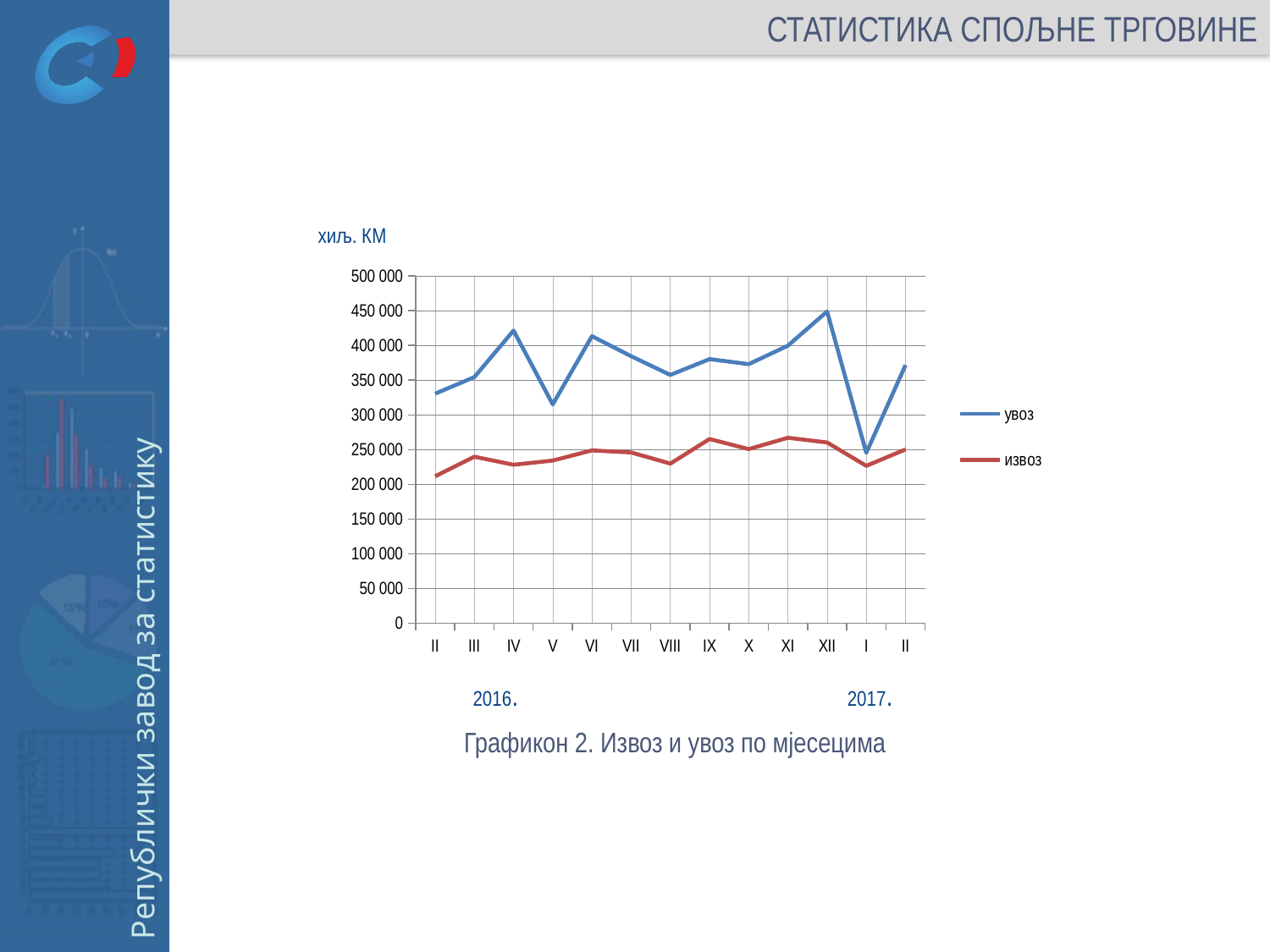
What unit is indicated above the chart? хиљ. КМ In which month does the увоз series reach its lowest value? I 2017 How many series does the legend list? 2 Which series has the larger value in VI 2016, увоз or извоз? увоз What kind of chart is shown on the slide? line chart Does the увоз series rise or fall from XII 2016 to I 2017? fall Is the value of увоз for XII 2016 greater or less than 400 000? greater In which month does the увоз series reach its highest value? XII 2016 How many months are plotted along the x axis? 13 Is the value of извоз for IX 2016 greater or less than 250 000? greater Is the value of извоз for II 2016 greater or less than 250 000? less